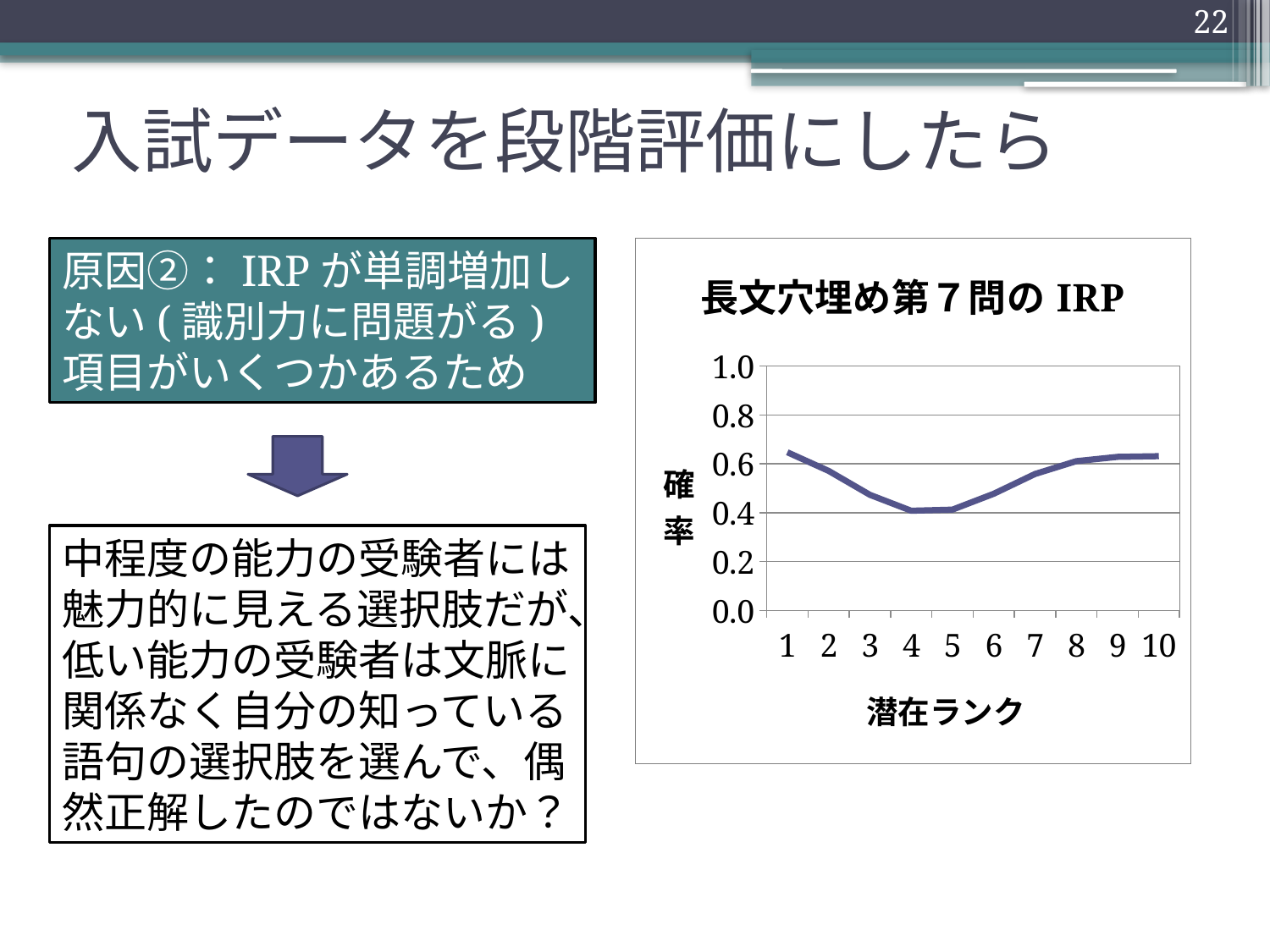
What is the title of the chart? 長文穴埋め第7問のIRP What kind of chart is shown on the slide? line chart Is the value for 潜在ランク 5 greater or less than 0.6? less Which has the larger value, 潜在ランク 1 or 潜在ランク 4? 潜在ランク 1 Is the value for 潜在ランク 10 greater or less than 0.8? less Do the values rise or fall from 潜在ランク 1 to 潜在ランク 4? fall Is the value for 潜在ランク 1 greater or less than 0.4? greater How many points (潜在ランク values) are plotted along the x axis? 10 What is the label of the x axis of the chart? 潜在ランク Which has the larger value, 潜在ランク 5 or 潜在ランク 9? 潜在ランク 9 Do the values rise or fall from 潜在ランク 5 to 潜在ランク 9? rise